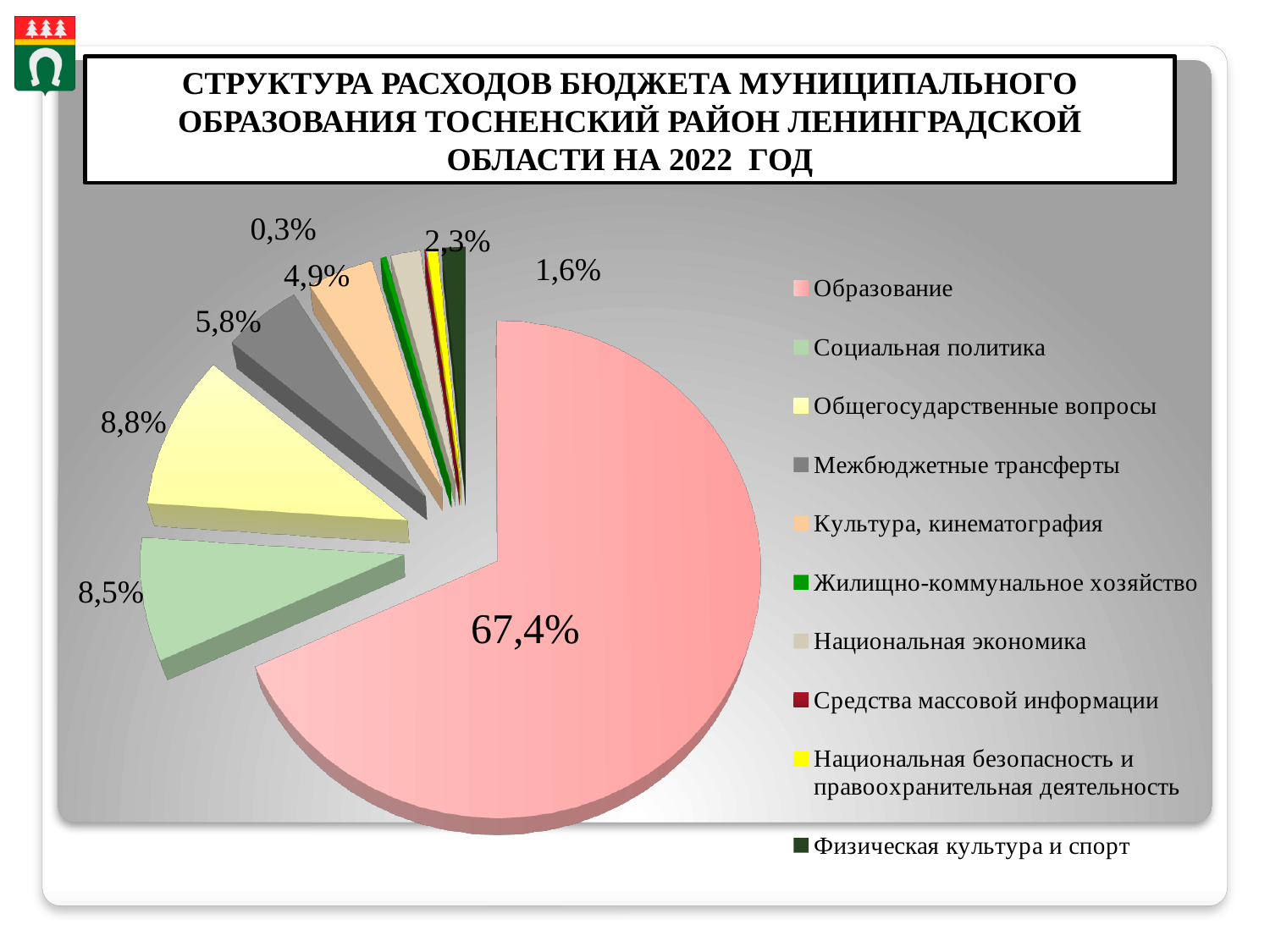
What share is shown for Культура, кинематография? 4,9% By how many percentage points does the share for Образование exceed the share for Социальная политика? 58,9 What share is shown for Социальная политика? 8,5% What share of the budget expenditure goes to Образование? 67,4% What share is shown for Межбюджетные трансферты? 5,8% What share is shown for Общегосударственные вопросы? 8,8% How many categories does the legend list? 10 What kind of chart is shown on the slide? pie chart For which year does the chart show the budget expenditure structure? 2022 Which is larger: the share for Межбюджетные трансферты or for Культура, кинематография? Межбюджетные трансферты Which category has the largest share of the budget expenditure? Образование Which is larger: the share for Общегосударственные вопросы or for Социальная политика? Общегосударственные вопросы